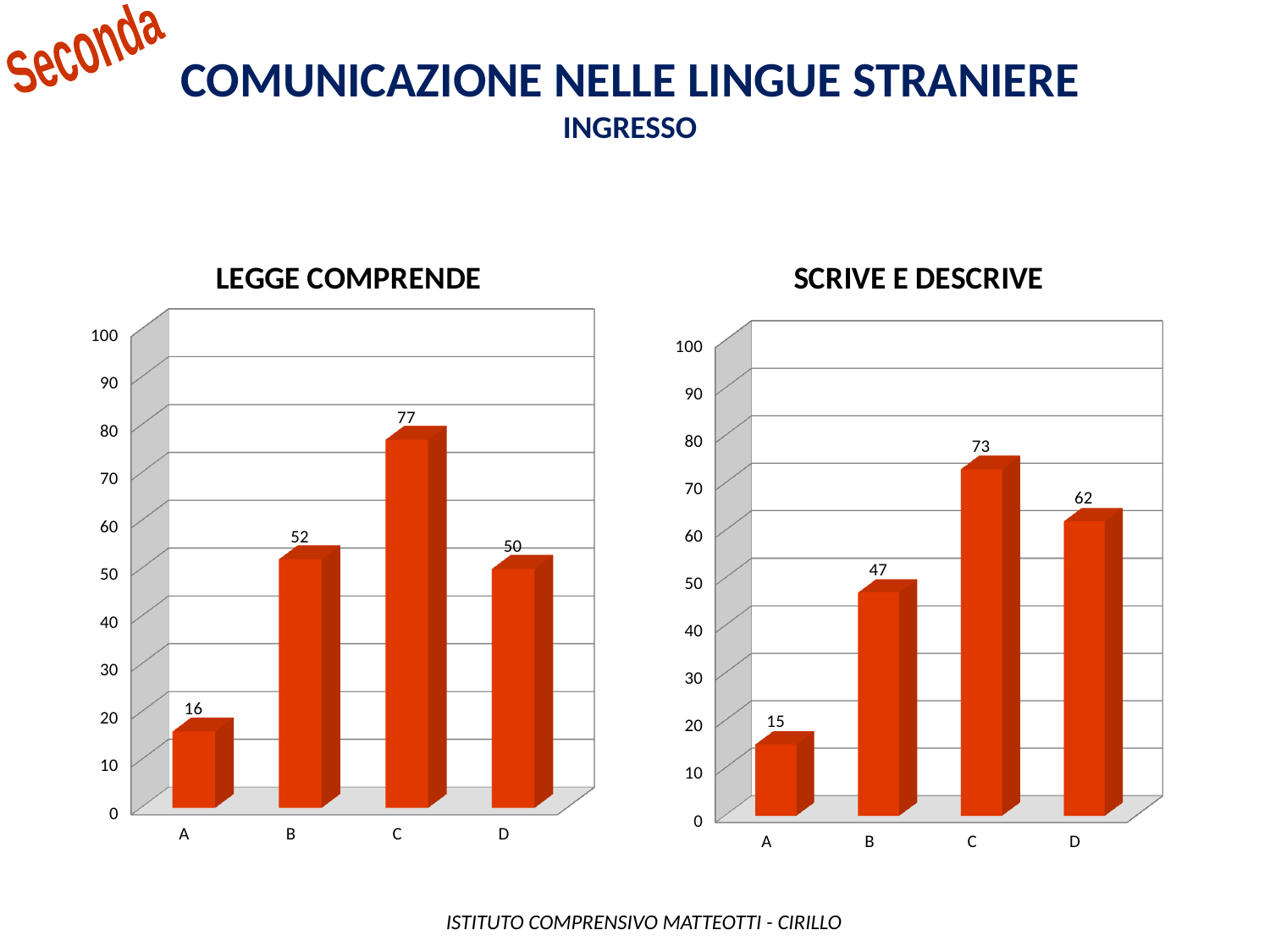
In the SCRIVE E DESCRIVE chart, which category has the highest value? C In the LEGGE COMPRENDE chart, what is the difference between the values for C and A? 61 How many categories are shown in the LEGGE COMPRENDE chart? 4 In the SCRIVE E DESCRIVE chart, what is the value for category B? 47 In the LEGGE COMPRENDE chart, which category has the lowest value? A What is the title of the chart on the left side of the slide? LEGGE COMPRENDE In the SCRIVE E DESCRIVE chart, what is the value for category A? 15 In the SCRIVE E DESCRIVE chart, what is the difference between the values for D and B? 15 In the LEGGE COMPRENDE chart, what is the value for category C? 77 In the SCRIVE E DESCRIVE chart, is the value for D greater or less than 50? greater What kind of chart is the SCRIVE E DESCRIVE chart? bar chart In the LEGGE COMPRENDE chart, which is larger, the value for B or the value for D? B